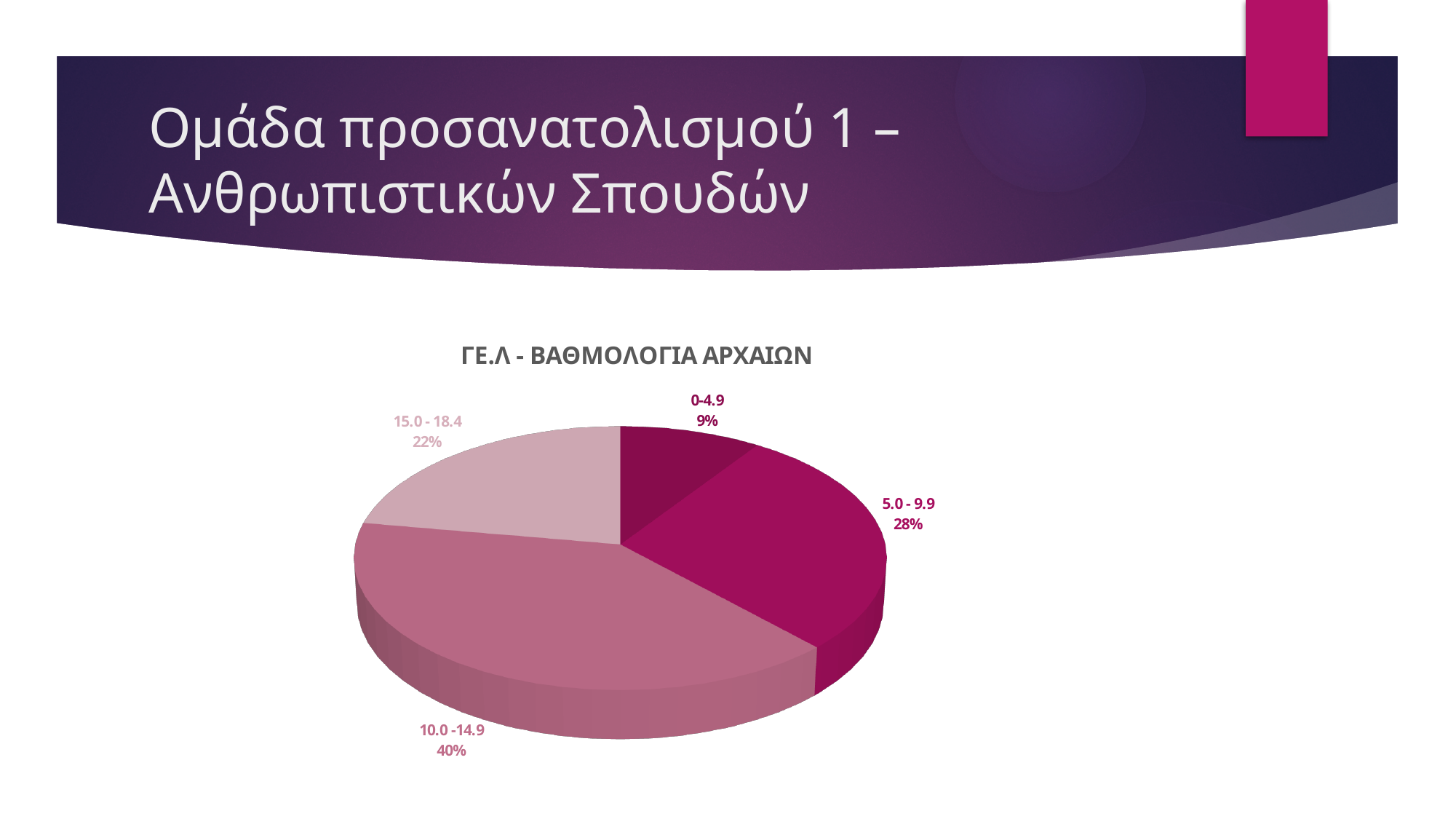
Which category has the smallest share of the pie? 0-4.9 What is the difference in percentage points between the 15.0 - 18.4 and 0-4.9 categories? 13 What share of the pie does the 5.0 - 9.9 category have? 28% Which category has a larger share, 5.0 - 9.9 or 15.0 - 18.4? 5.0 - 9.9 What share of the pie does the 15.0 - 18.4 category have? 22% What type of chart is shown on the slide? Pie chart What is the title of the chart? ΓΕ.Λ - ΒΑΘΜΟΛΟΓΙΑ ΑΡΧΑΙΩΝ Which category has the largest share of the pie? 10.0 -14.9 What share of the pie does the 10.0 -14.9 category have? 40% What is the difference in percentage points between the 10.0 -14.9 and 5.0 - 9.9 categories? 12 How many categories are shown in the pie chart? 4